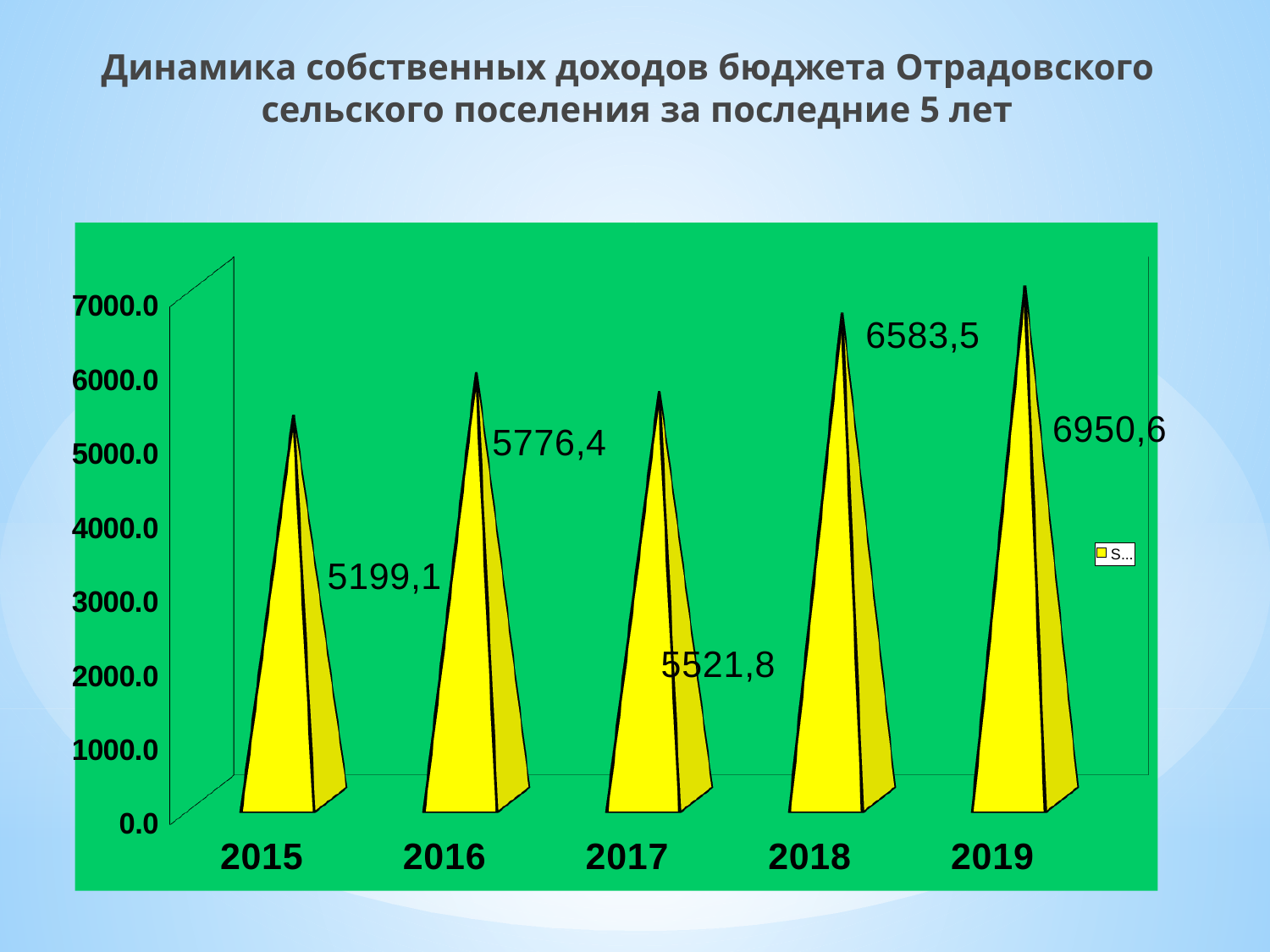
What is the difference between the values for 2019 and 2018? 367,1 How many years are shown on the x axis? 5 What is the difference between the values for 2016 and 2015? 577,3 Which year has the lowest value? 2015 Is the value for 2018 greater or less than 6000.0? greater Which year has the highest value? 2019 What kind of chart is shown on the slide? bar chart What is the value for 2019? 6950,6 What is the value for 2015? 5199,1 Which is larger, the value for 2016 or the value for 2017? 2016 Does the value rise or fall from 2017 to 2019? rise What is the value for 2017? 5521,8